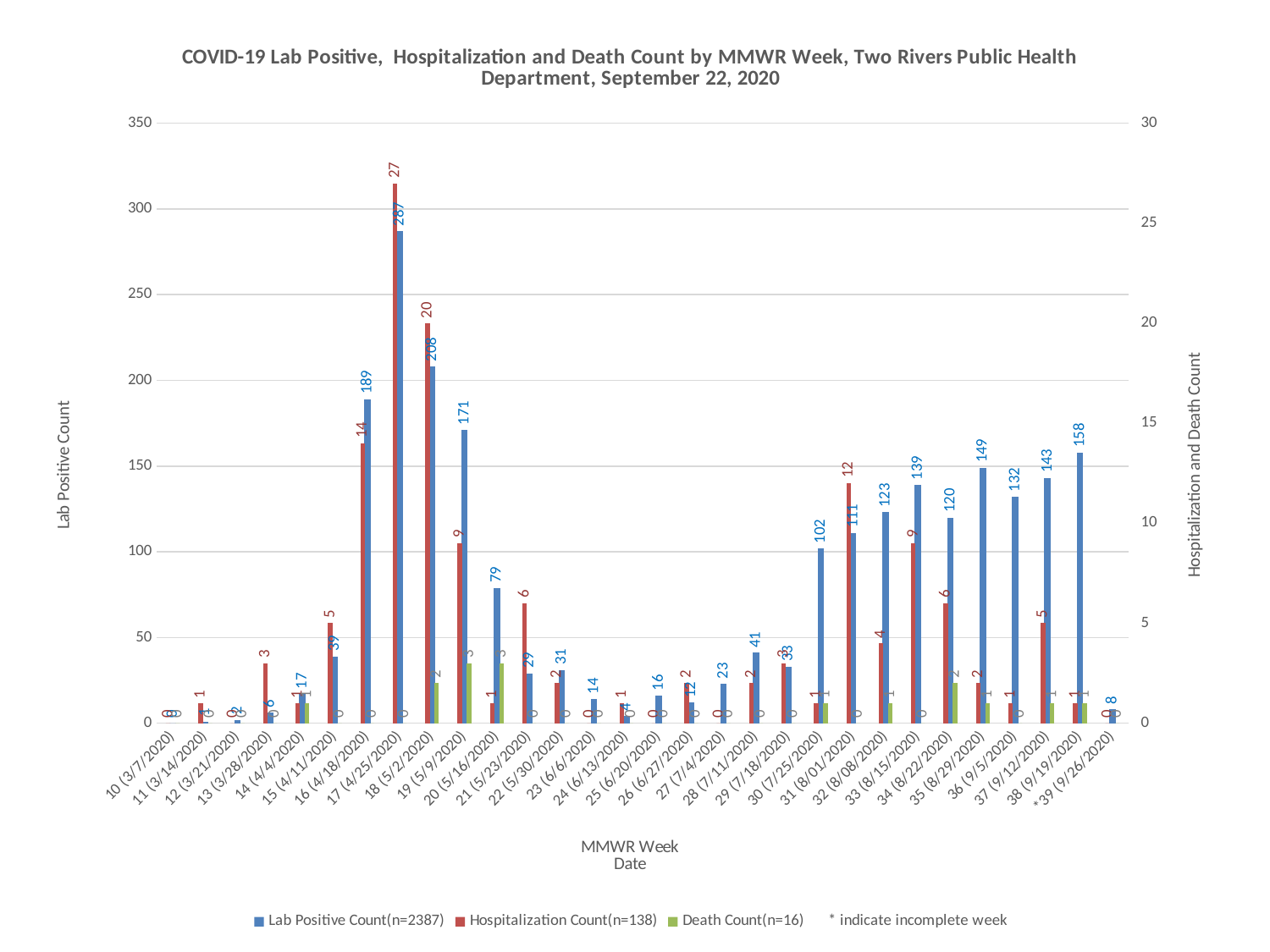
What is the Lab Positive Count for MMWR week 38 (9/19/2020)? 158 What is the Lab Positive Count for MMWR week 17 (4/25/2020)? 287 What is the Hospitalization Count for MMWR week 18 (5/2/2020)? 20 Which MMWR week has the highest Lab Positive Count? 17 (4/25/2020) Which MMWR week has the highest Hospitalization Count? 17 (4/25/2020) How many MMWR weeks are shown on the x axis? 30 Which is larger, the Lab Positive Count for week 35 (8/29/2020) or week 36 (9/5/2020)? 35 (8/29/2020) What kind of chart is shown on the slide? Bar chart Is the Lab Positive Count for week 19 (5/9/2020) greater or less than 150? greater How many series does the legend list? 3 What is the difference between the Lab Positive Count for week 16 (4/18/2020) and week 17 (4/25/2020)? 98 What does the asterisk (*) next to week 39 indicate, according to the legend? Incomplete week